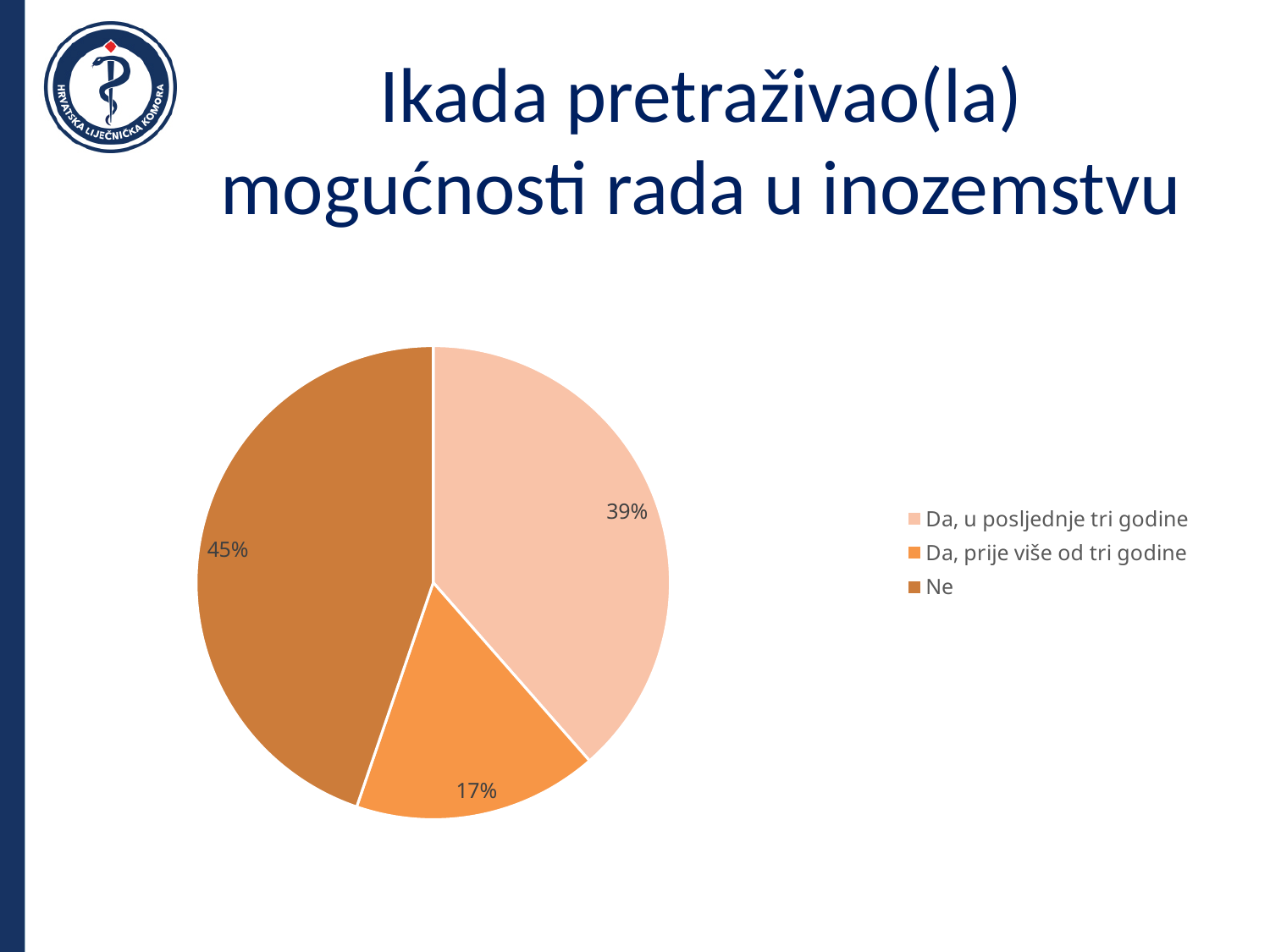
How many entries does the legend list? 3 What kind of chart is shown on the slide? pie chart What share of the pie does "Ne" take? 45% Which category has the largest slice of the pie? Ne Which category has the smallest slice of the pie? Da, prije više od tri godine What share of the pie does "Da, u posljednje tri godine" take? 39% Which is larger: the slice for "Ne" or the slice for "Da, prije više od tri godine"? Ne What is the difference in percentage points between "Da, u posljednje tri godine" and "Da, prije više od tri godine"? 22 What is the difference in percentage points between "Ne" and "Da, u posljednje tri godine"? 6 What share of the pie does "Da, prije više od tri godine" take? 17% How many slices does the pie chart have? 3 What is the title of the slide containing the pie chart? Ikada pretraživao(la) mogućnosti rada u inozemstvu